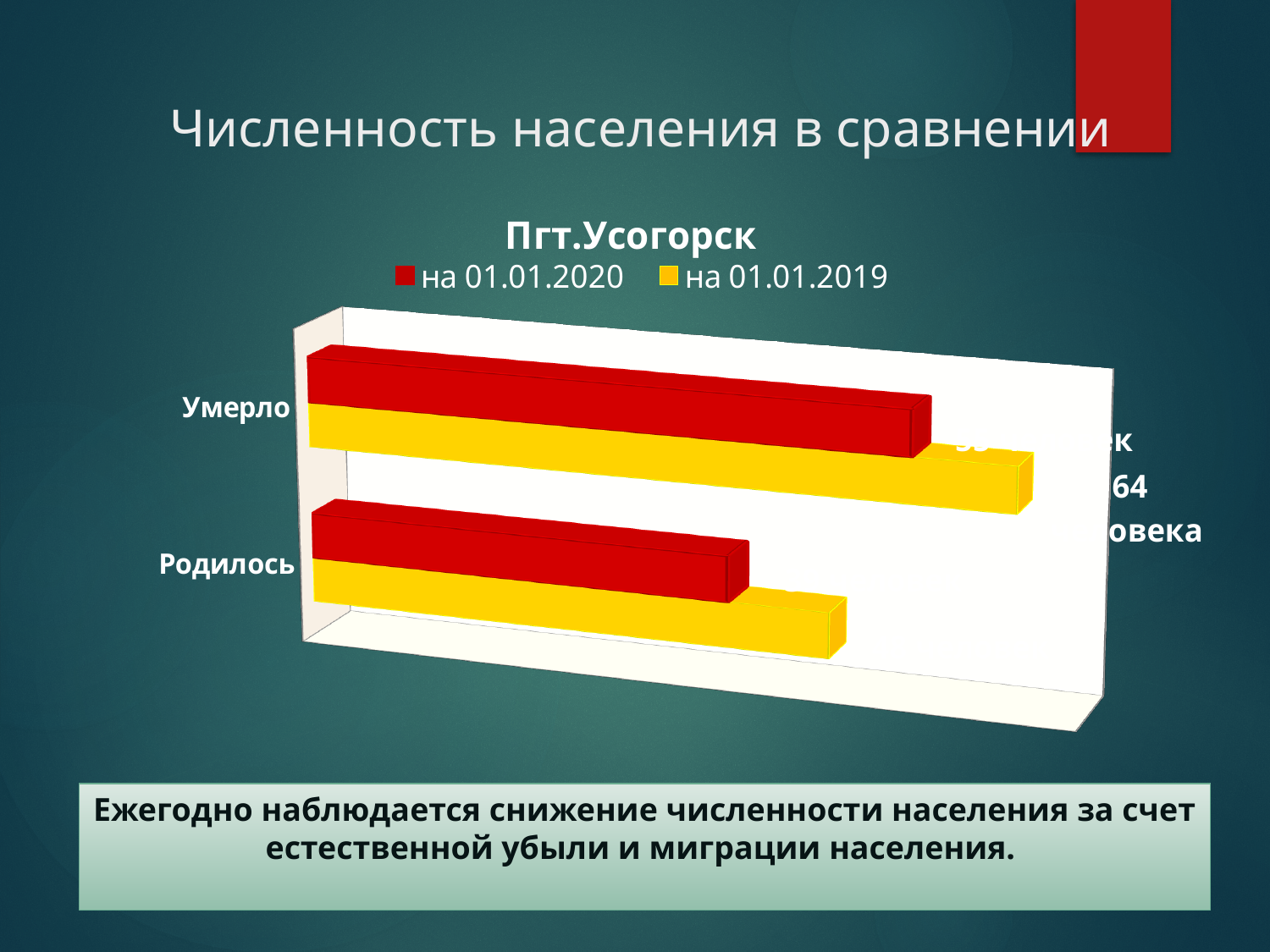
What is the title of the chart? Пгт.Усогорск Which category has the lowest value for the series на 01.01.2020? Родилось For the category Умерло, which series has the larger value: на 01.01.2020 or на 01.01.2019? на 01.01.2019 Which category has the highest value for the series на 01.01.2020? Умерло For the category Родилось, which series has the larger value: на 01.01.2020 or на 01.01.2019? на 01.01.2019 How many categories are shown on the chart? 2 Which category has the highest value for the series на 01.01.2019? Умерло What kind of chart is shown on the slide? bar chart Which category has the lowest value for the series на 01.01.2019? Родилось Which series is shown in red in the chart? на 01.01.2020 How many series does the chart legend list? 2